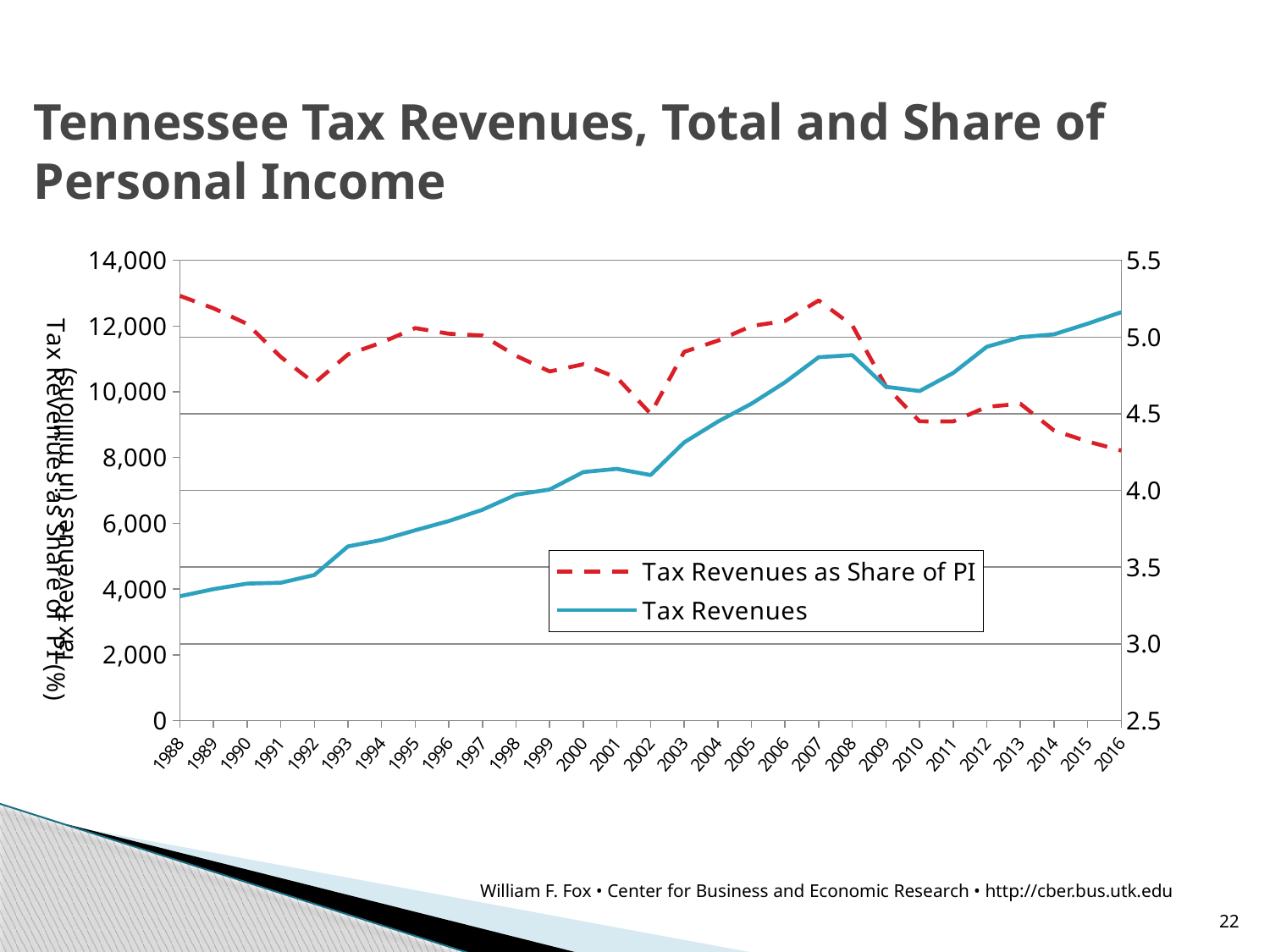
How many series does the legend list? 2 Does the Tax Revenues series generally rise or fall from 1988 to 2016? rise Is the Tax Revenues value for 2016 greater or less than 12,000? greater Is the Tax Revenues value for 1988 greater or less than 4,000? less What kind of chart is shown on the slide? line chart In which year is the Tax Revenues as Share of PI series at its lowest? 2016 Is the Tax Revenues as Share of PI value for 1988 greater or less than 5.0? greater In which year is the Tax Revenues series at its highest? 2016 Which series is drawn with a dashed red line? Tax Revenues as Share of PI In which year is the Tax Revenues series at its lowest? 1988 Which year has the higher Tax Revenues value, 2008 or 2009? 2008 How many years are plotted along the x axis? 29